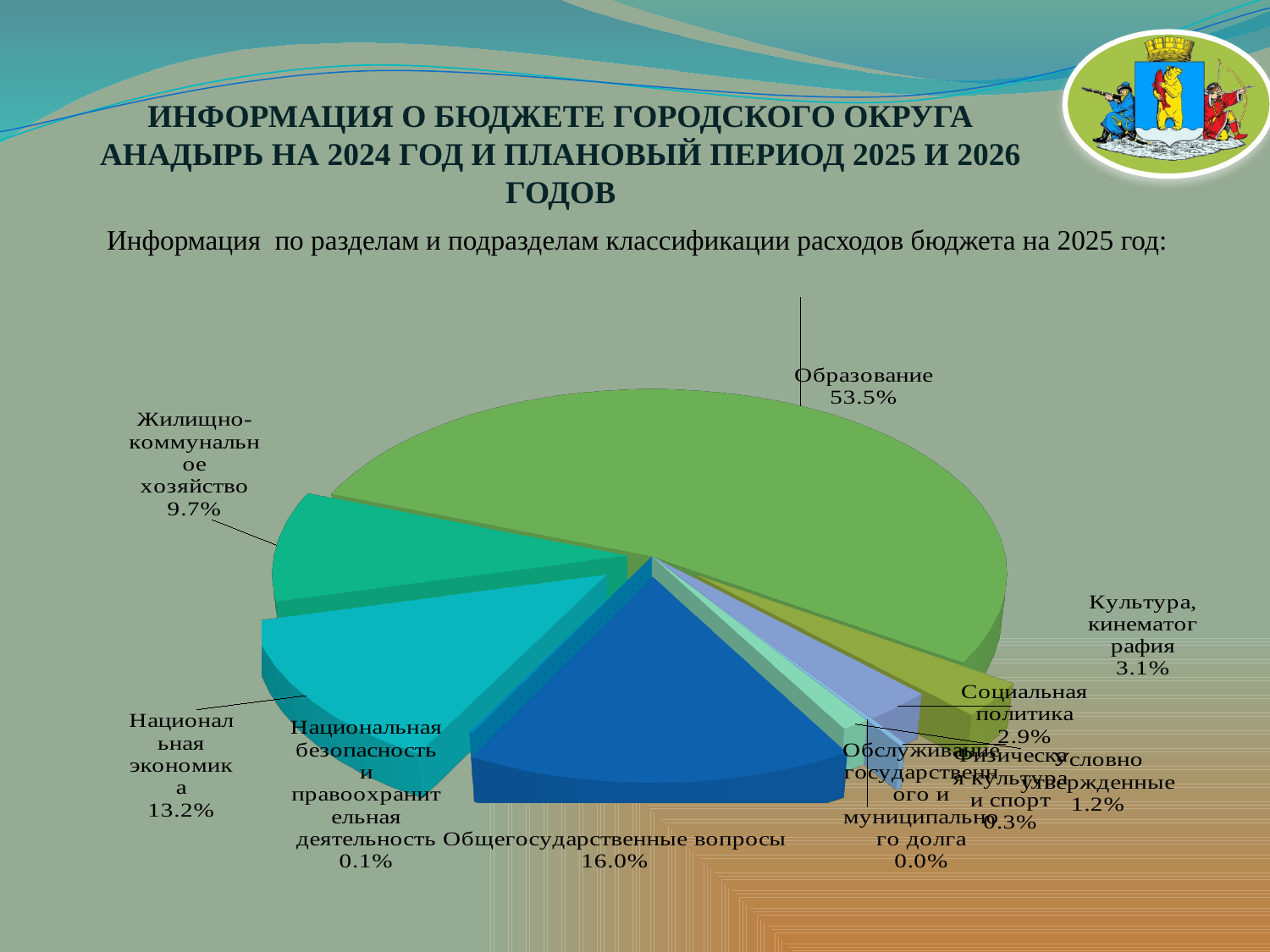
How many categories are shown in the pie chart? 10 What is the combined share of Национальная экономика and Жилищно-коммунальное хозяйство? 22.9% What is the value for Жилищно-коммунальное хозяйство? 9.7% What type of chart is shown on the slide? Pie chart What percentage is shown for Национальная экономика? 13.2% Which category has the smallest share shown on the chart? Обслуживание государственного и муниципального долга What share of the pie does Образование have? 53.5% What is the value shown for Общегосударственные вопросы? 16.0% What share is shown for Социальная политика? 2.9% Which is larger: the share of Культура, кинематография or the share of Социальная политика? Культура, кинематография What is the difference between the shares of Образование and Общегосударственные вопросы? 37.5% Which category has the largest slice of the pie? Образование